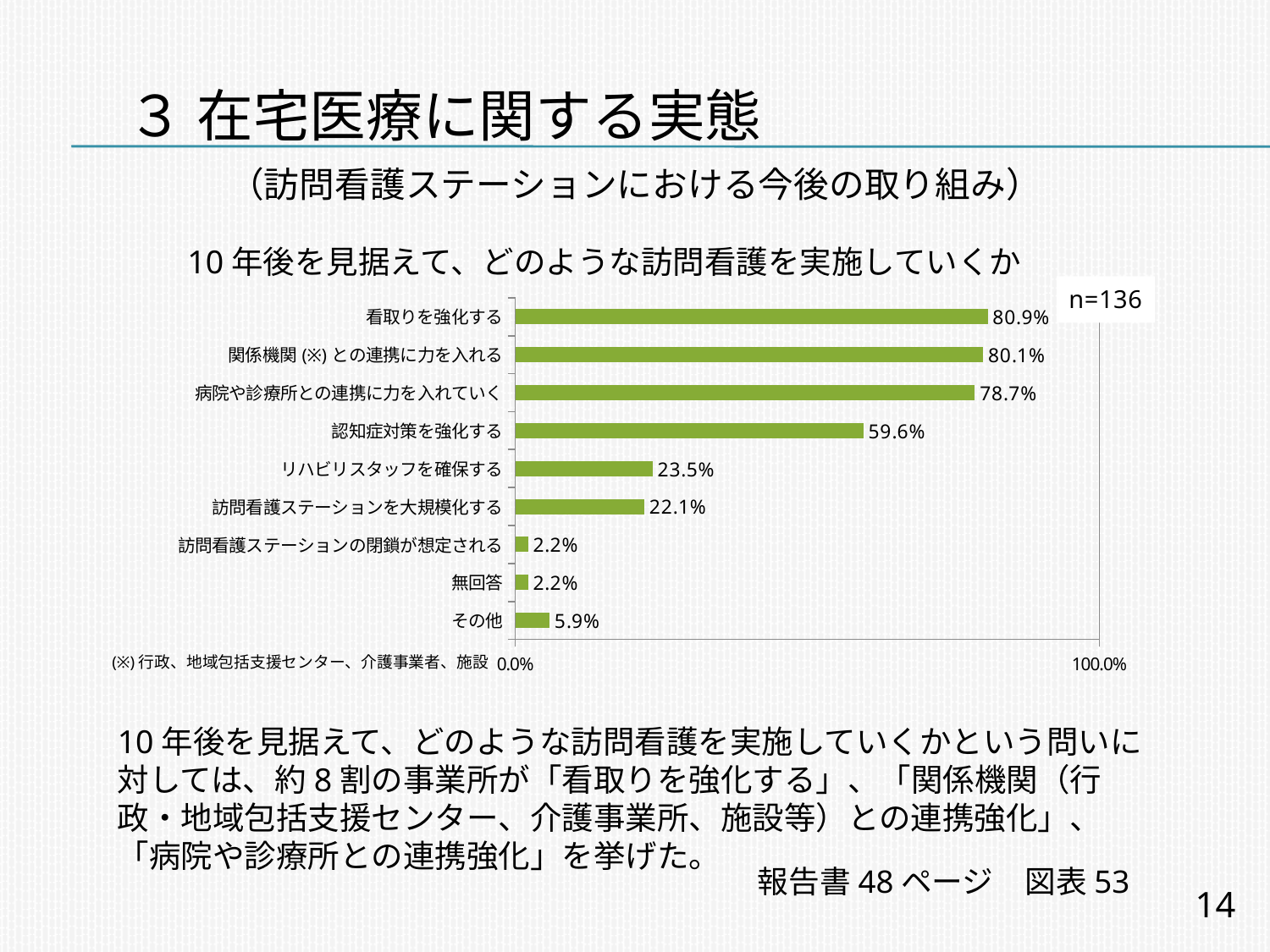
What sample size (n) is shown next to the chart? n=136 What percentage is shown for その他? 5.9% How many categories are shown in the chart? 9 What percentage is shown for リハビリスタッフを確保する? 23.5% What kind of chart is shown on the slide? Bar chart Which is larger, the value for 認知症対策を強化する or the value for リハビリスタッフを確保する? 認知症対策を強化する What is the difference between the values for 看取りを強化する and 認知症対策を強化する? 21.3 percentage points What is the difference between the values for リハビリスタッフを確保する and 訪問看護ステーションを大規模化する? 1.4 percentage points What is the value shown for 認知症対策を強化する? 59.6% Which category has the highest value in the chart? 看取りを強化する What percentage of respondents chose 看取りを強化する? 80.9% What is the value for 訪問看護ステーションを大規模化する? 22.1%